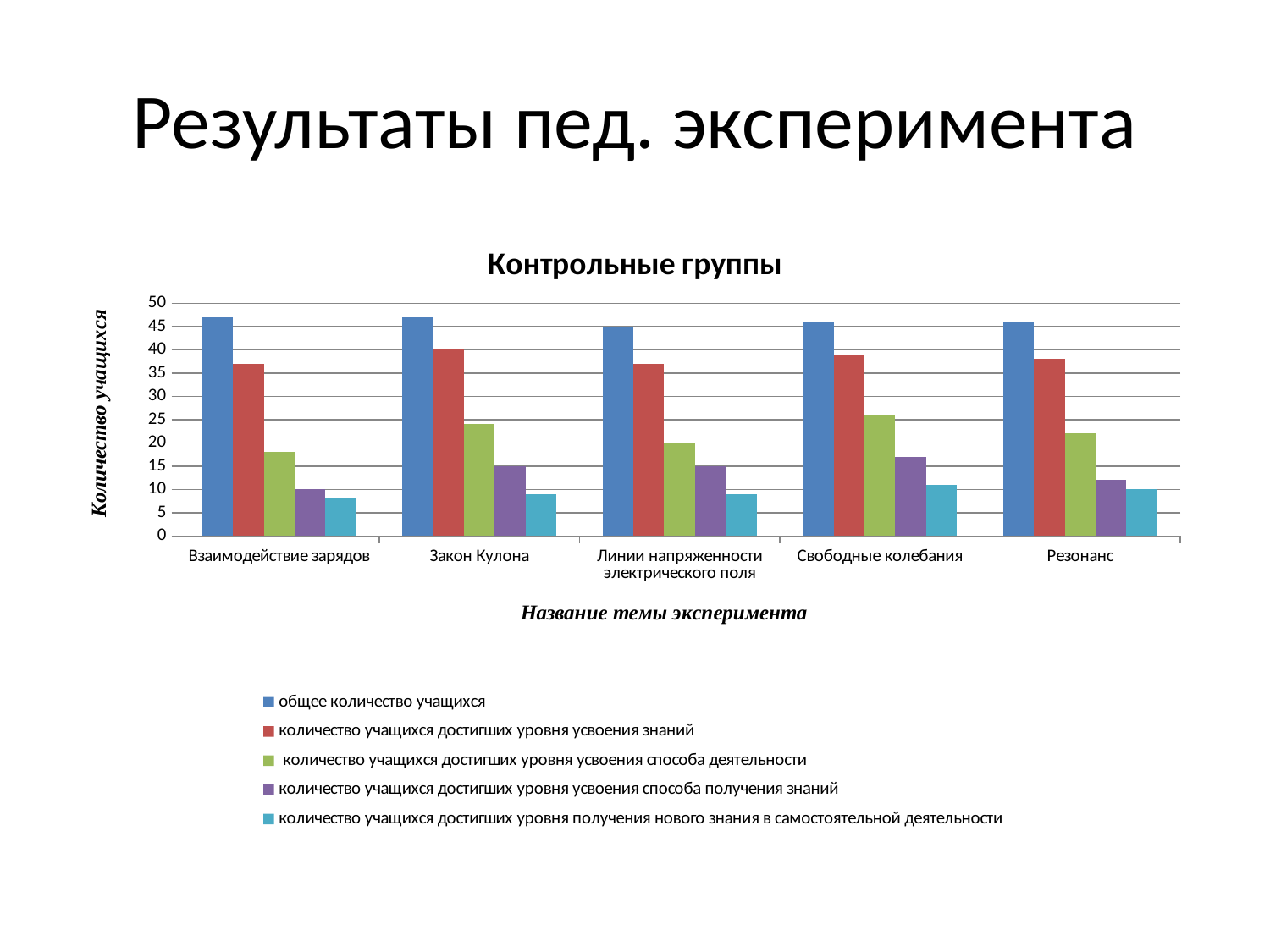
Is the value of 'общее количество учащихся' for Взаимодействие зарядов greater or less than 45? greater How many categories (experiment topics) are shown on the x axis? 5 What is the label of the vertical axis? Количество учащихся How many series does the legend list? 5 What is the title of the chart? Контрольные группы What is the value of 'количество учащихся достигших уровня усвоения способа деятельности' for Линии напряженности электрического поля? 20 Which is larger for Закон Кулона: 'общее количество учащихся' or 'количество учащихся достигших уровня усвоения знаний'? общее количество учащихся What kind of chart is shown on the slide? bar chart Is the value of 'количество учащихся достигших уровня получения нового знания в самостоятельной деятельности' for Взаимодействие зарядов greater or less than 10? less What is the value of 'количество учащихся достигших уровня усвоения знаний' for Закон Кулона? 40 Which topic has the highest value for 'количество учащихся достигших уровня усвоения способа деятельности'? Свободные колебания Is the value of 'количество учащихся достигших уровня усвоения знаний' for Резонанс greater or less than 40? less